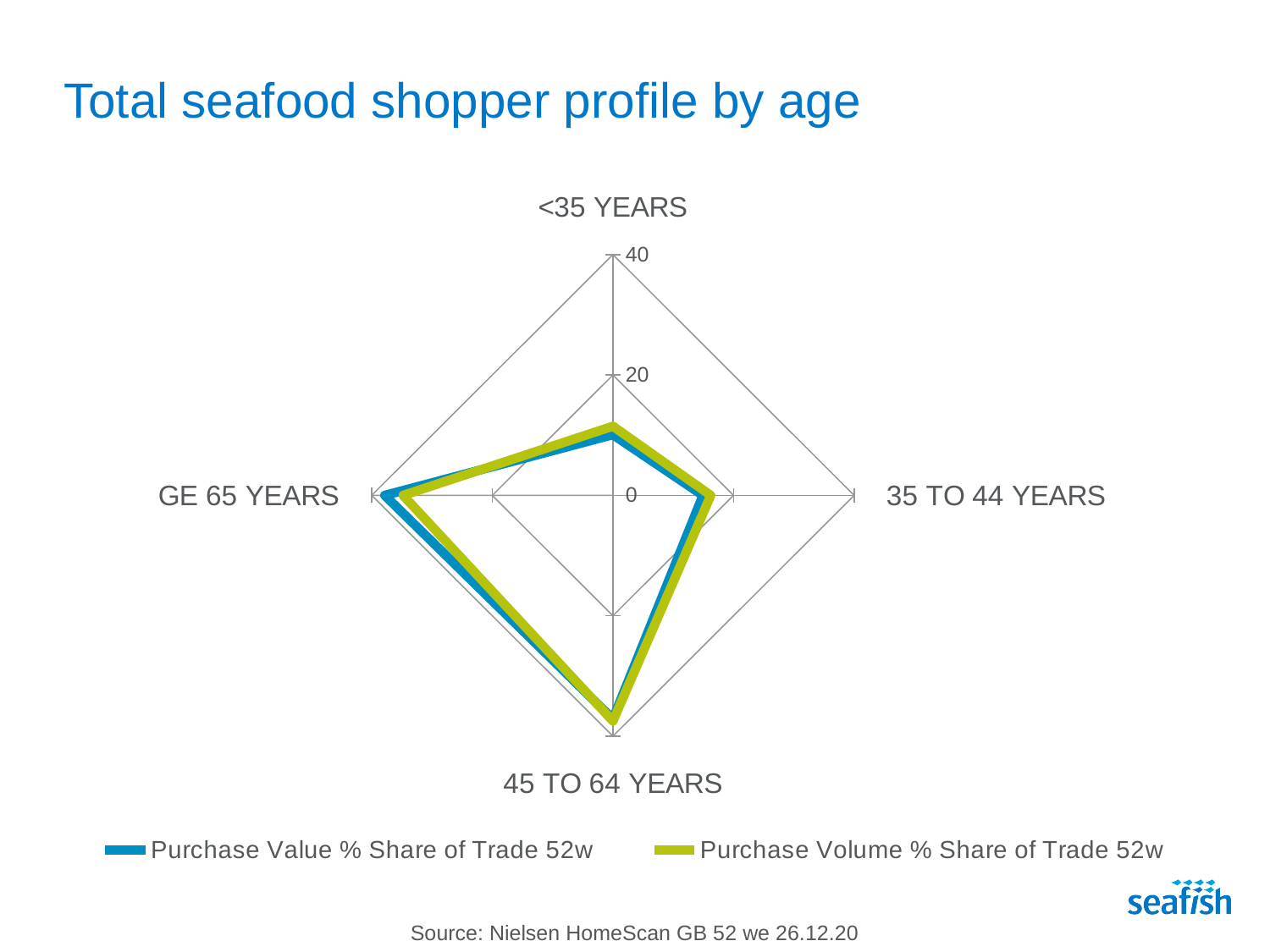
Is the Purchase Volume % Share of Trade 52w for 35 TO 44 YEARS greater or less than 20? less How many series does the legend list? 2 Which has the larger share of trade, <35 YEARS or 35 TO 44 YEARS? 35 TO 44 YEARS Which age category has the lowest share of trade? <35 YEARS How many age categories are plotted on the chart? 4 What is the title of the chart? Total seafood shopper profile by age What kind of chart is shown on the slide? Radar chart What is the highest value shown on the chart's axis scale? 40 Is the Purchase Volume % Share of Trade 52w for 45 TO 64 YEARS greater or less than 20? greater Is the Purchase Value % Share of Trade 52w for <35 YEARS greater or less than 20? less Which has the larger share of trade, <35 YEARS or 45 TO 64 YEARS? 45 TO 64 YEARS